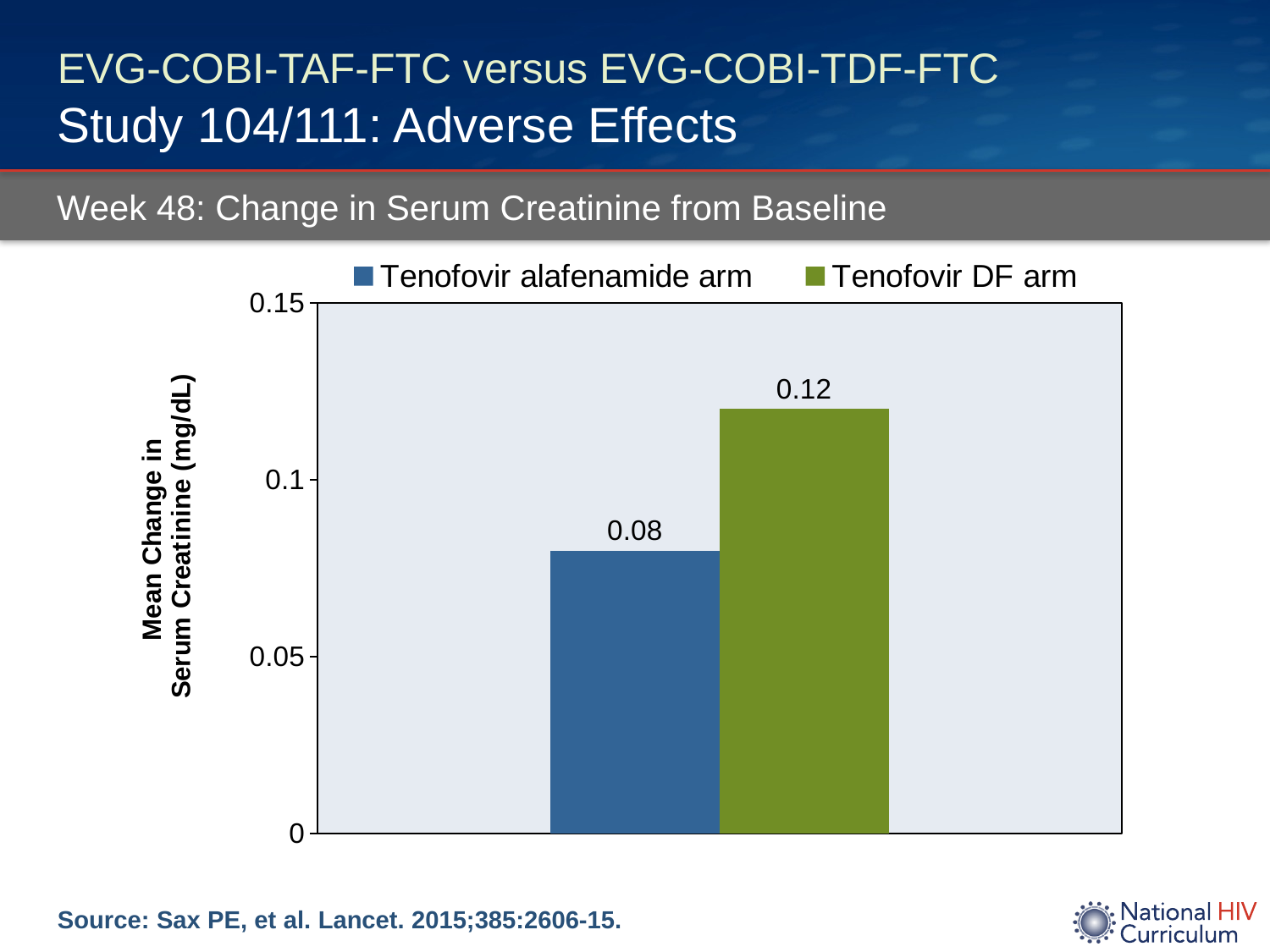
Which arm has the lower mean change in serum creatinine? Tenofovir alafenamide arm Which arm has the higher mean change in serum creatinine? Tenofovir DF arm Is the mean change in serum creatinine larger for the Tenofovir alafenamide arm or the Tenofovir DF arm? Tenofovir DF arm What is the mean change in serum creatinine for the Tenofovir alafenamide arm? 0.08 Is the value for the Tenofovir DF arm greater or less than 0.1? greater Is the value for the Tenofovir alafenamide arm greater or less than 0.1? less What is the difference in mean change in serum creatinine between the Tenofovir DF arm and the Tenofovir alafenamide arm? 0.04 How many bars are plotted in the chart? 2 What is the unit shown on the y-axis label of the chart? mg/dL What type of chart is shown on the slide? Bar chart What is the mean change in serum creatinine for the Tenofovir DF arm? 0.12 How many series does the legend list? 2